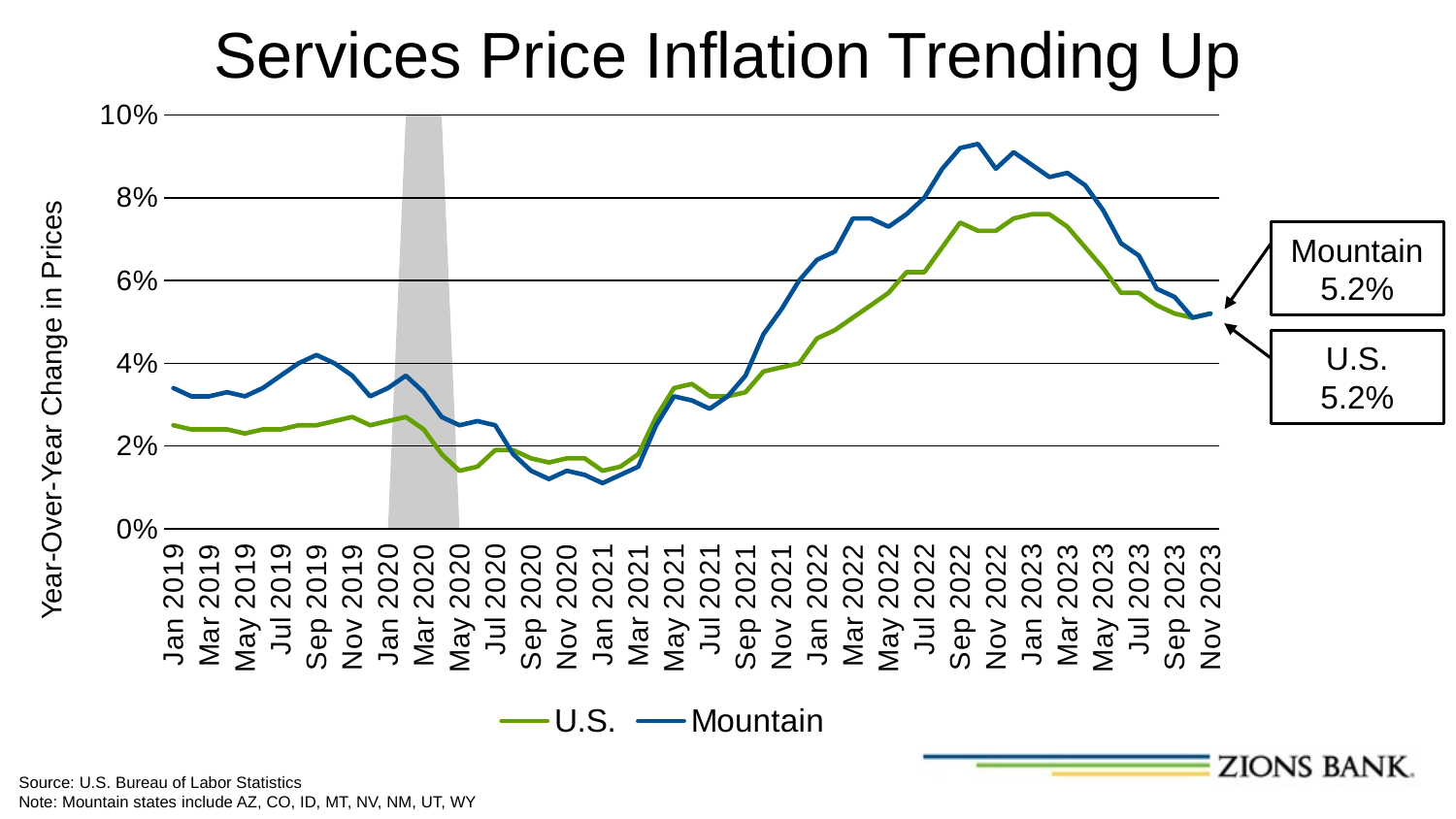
Is the Mountain value in Jan 2022 greater or less than 6%? greater Is the U.S. value in Jan 2021 greater or less than 2%? less What kind of chart is shown on the slide? line chart What is the title of the chart? Services Price Inflation Trending Up In Jan 2020, which series is higher, U.S. or Mountain? Mountain What is the labelled value for the U.S. series at the end of the chart (Nov 2023)? 5.2% Does the U.S. series rise or fall between Jan 2023 and Nov 2023? fall What is the labelled value for the Mountain series at the end of the chart (Nov 2023)? 5.2% Is the Mountain value in Sep 2022 greater or less than 8%? greater Does the Mountain series rise or fall between Jan 2021 and Sep 2022? rise In Sep 2022, which series is higher, U.S. or Mountain? Mountain How many series does the legend list? 2